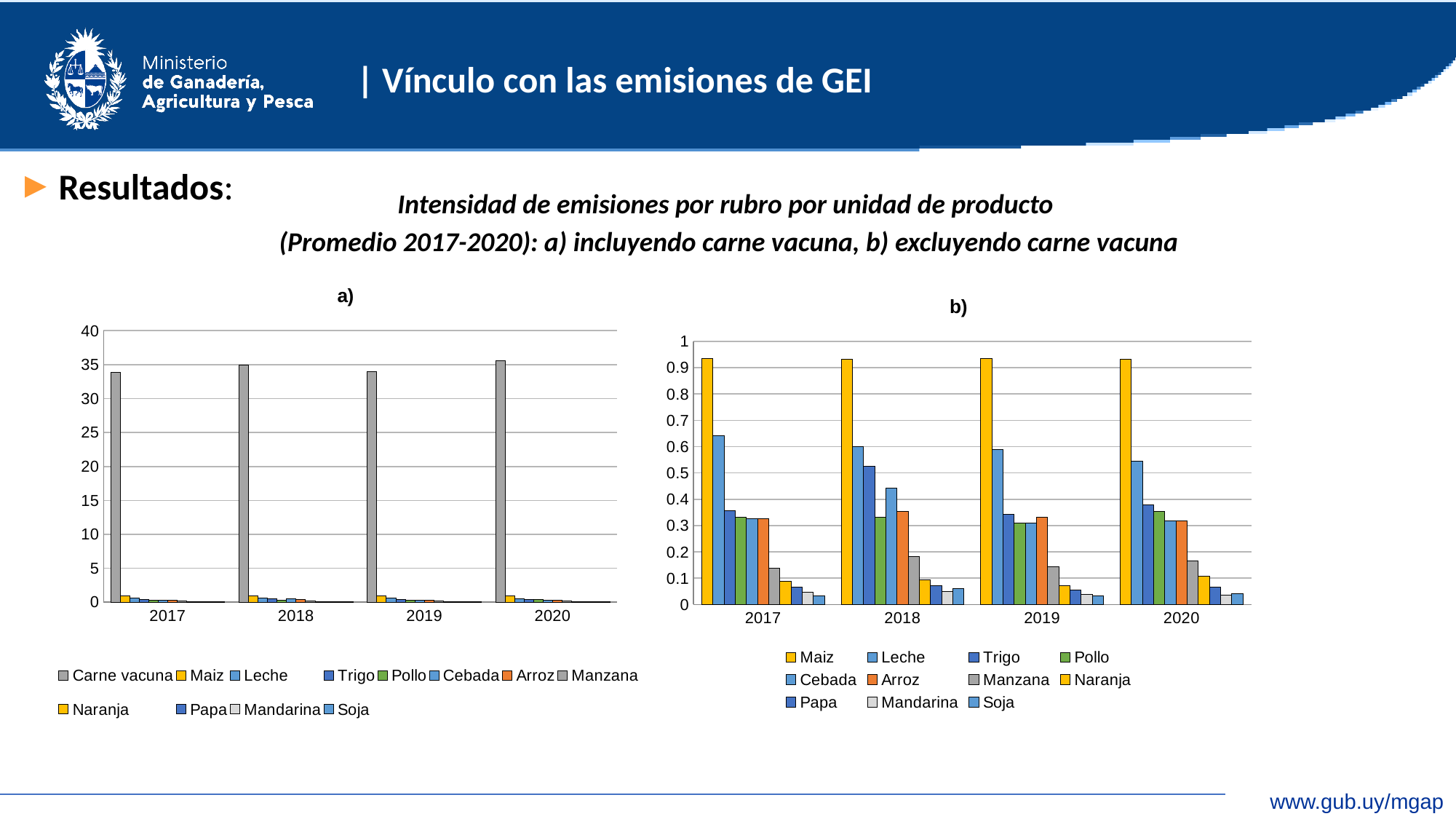
How many series does the legend of chart a) list? 12 In chart a), which series has the highest value in 2017? Carne vacuna In chart b), which series has the highest value in 2019? Maiz In chart b), do the values for Leche rise or fall from 2017 to 2020? fall How many series does the legend of chart b) list? 11 In chart b), which is larger: the value for Leche in 2017 or in 2020? 2017 In chart a), is the value for Carne vacuna in 2017 greater or less than 30? greater In chart b), is the value for Cebada in 2018 greater or less than 0.4? greater In chart b), is the value for Maiz in 2017 greater or less than 0.9? greater How many year categories are shown on the x axis of chart b)? 4 What kind of chart is chart a)? bar chart